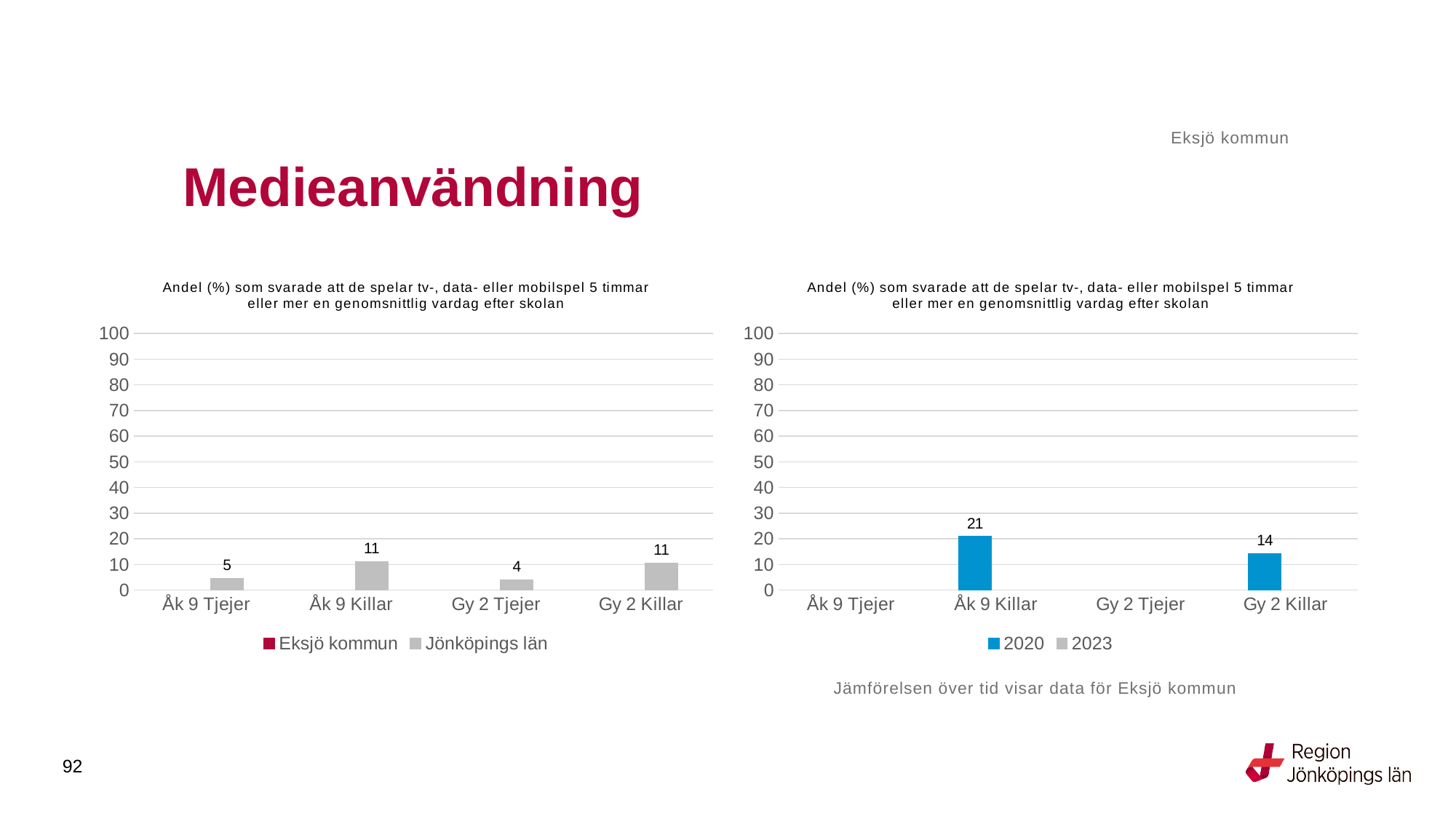
In the right chart, what is the difference between the 2020 values for Åk 9 Killar and Gy 2 Killar? 7 In the right chart, what is the 2020 value for Gy 2 Killar? 14 What kind of chart is the right chart? Bar chart In the right chart, what is the 2020 value for Åk 9 Killar? 21 In the left chart, what is the Jönköpings län value for Åk 9 Killar? 11 In the right chart, is the 2020 value for Åk 9 Killar greater or less than 20? greater In the right chart, which category has the highest 2020 value? Åk 9 Killar In the left chart, what is the Jönköpings län value for Gy 2 Tjejer? 4 In the left chart, how many series does the legend list? 2 In the left chart, what is the difference between the Jönköpings län values for Åk 9 Killar and Åk 9 Tjejer? 6 In the left chart, which category has the lowest Jönköpings län value? Gy 2 Tjejer In the left chart, what is the Jönköpings län value for Åk 9 Tjejer? 5